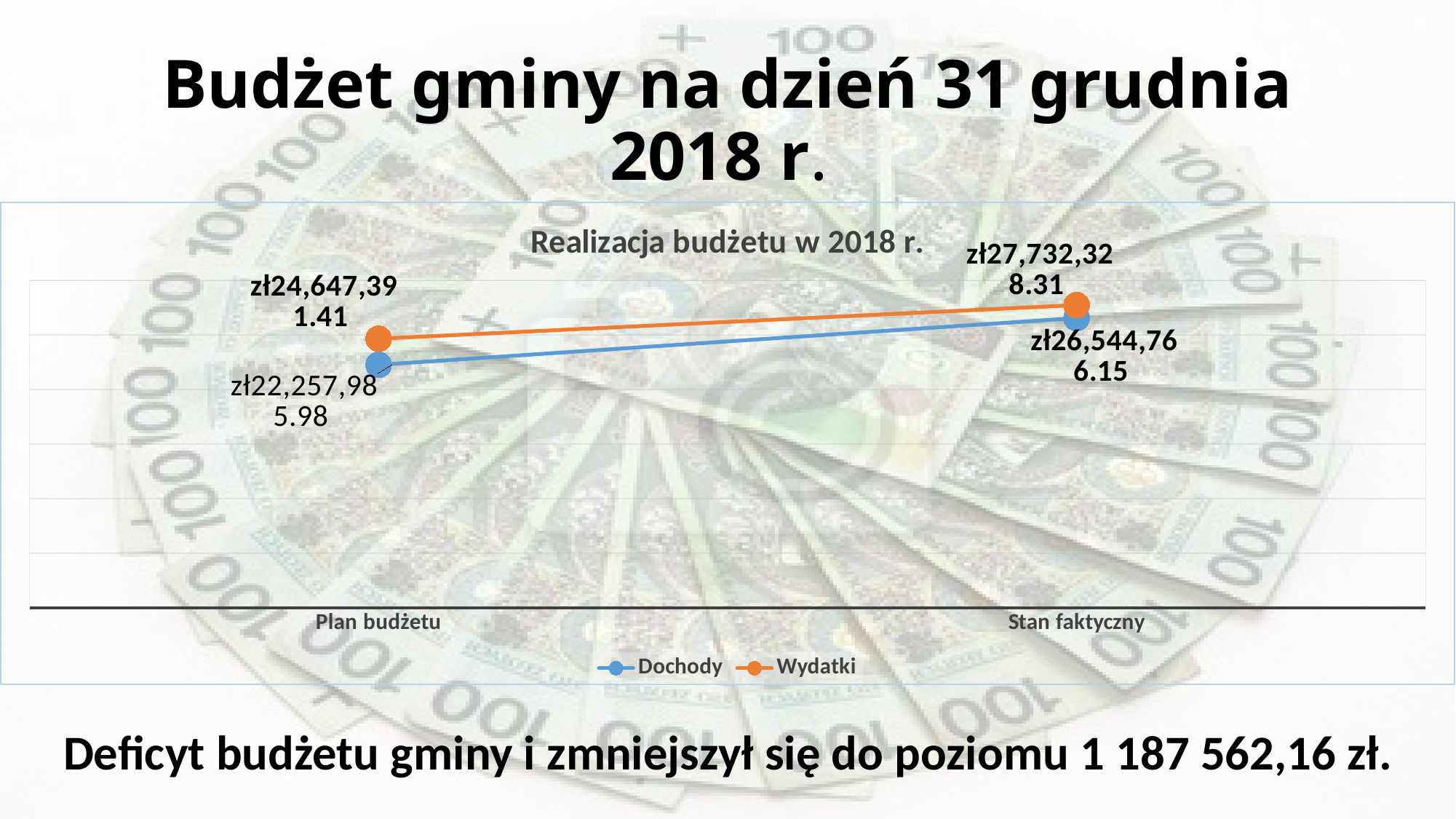
Do the Dochody values rise or fall from Plan budżetu to Stan faktyczny? rise What is the value of Wydatki for Stan faktyczny? zł27,732,328.31 What is the value of Dochody for Stan faktyczny? zł26,544,766.15 What is the value of Dochody for Plan budżetu? zł22,257,985.98 What type of chart is shown on the slide? line chart How many series does the chart legend list? 2 Which series has the higher value for Stan faktyczny, Dochody or Wydatki? Wydatki What is the value of Wydatki for Plan budżetu? zł24,647,391.41 What is the difference between Wydatki and Dochody for Plan budżetu? zł2,389,405.43 What is the difference between Wydatki and Dochody for Stan faktyczny? zł1,187,562.16 What is the title of the chart? Realizacja budżetu w 2018 r. How many categories are shown on the x axis of the chart? 2